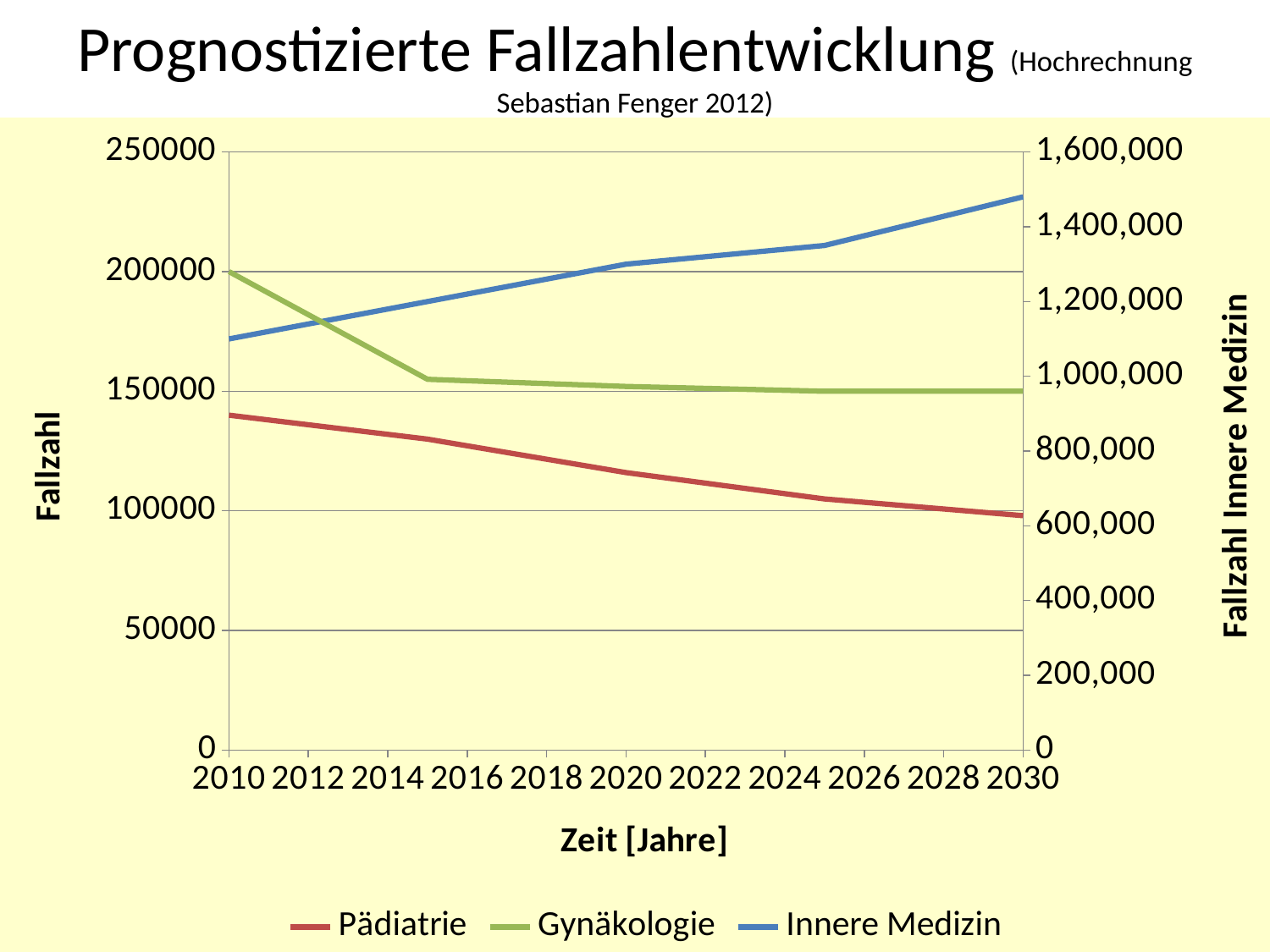
Does the Pädiatrie line rise or fall from 2010 to 2030? fall What is the value for Gynäkologie in 2010? 200000 Does the Gynäkologie line rise or fall from 2010 to 2030? fall What kind of chart is shown on the slide? line chart Is the value for Pädiatrie in 2010 greater or less than 100000? greater What is the title of the x axis? Zeit [Jahre] Is the value for Innere Medizin in 2010 greater or less than 1,000,000? greater Is the value for Innere Medizin in 2030 greater or less than 1,400,000? greater How many series does the legend list? 3 Does the Innere Medizin line rise or fall from 2010 to 2030? rise What is the title of the right-hand (secondary) y axis? Fallzahl Innere Medizin In 2030, which is larger on the left axis: Pädiatrie or Gynäkologie? Gynäkologie